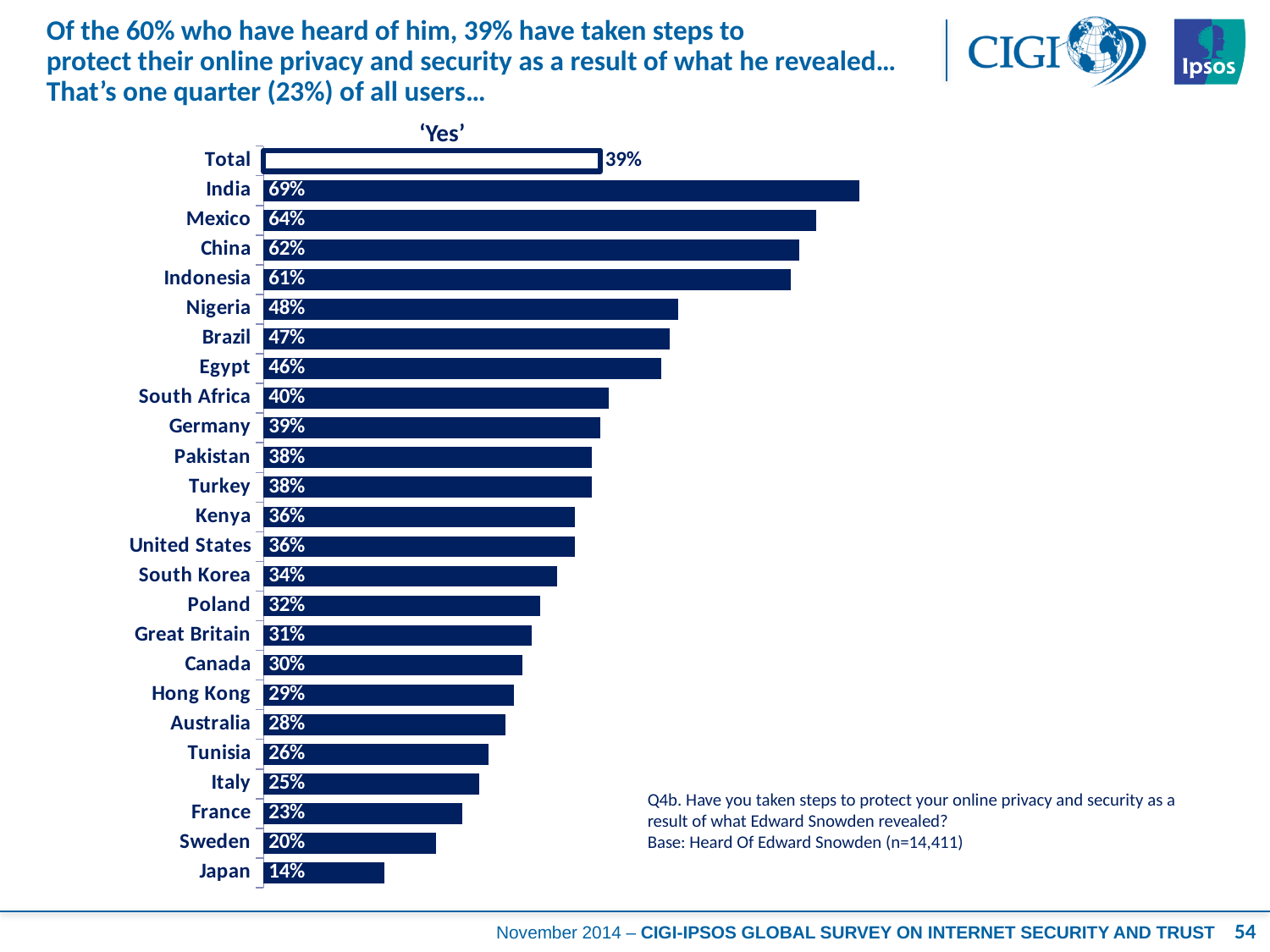
Which country has the lowest value? Japan Which country has the highest value? India Which is larger, the value for Nigeria or the value for Canada? Nigeria What kind of chart is shown on the slide? Bar chart What is the value for India? 69% What is the label shown above the chart? 'Yes' What is the value for Germany? 39% What is the difference between the values for Mexico and Sweden? 44% What is the value for the Total bar? 39% What is the value for Japan? 14% How many country bars are shown, excluding the Total bar? 24 What is the difference between the values for India and Japan? 55%